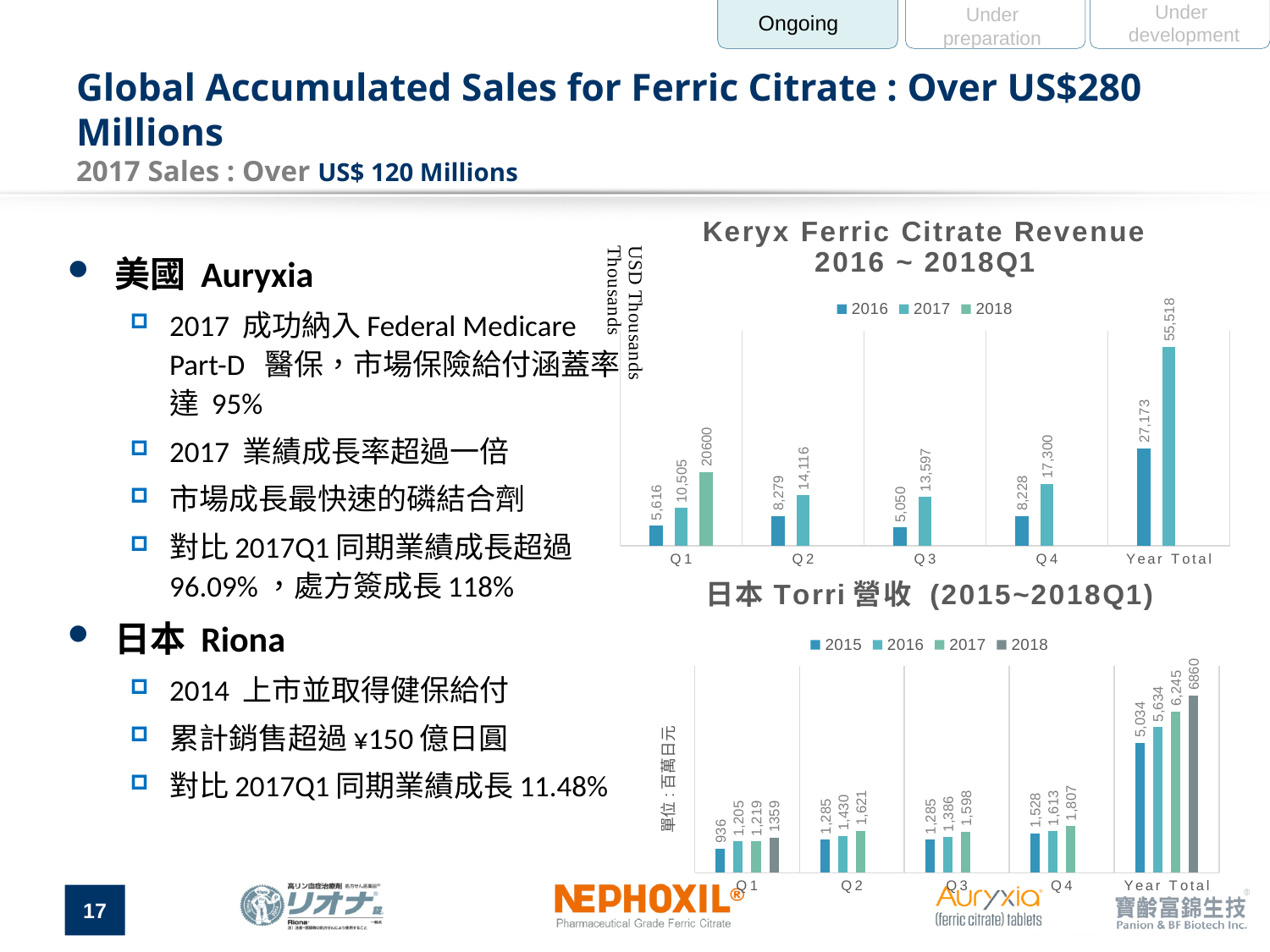
In the 日本 Torri 營收 chart, what is the 2015 value for Q1? 936 In the Keryx Ferric Citrate Revenue chart, what is the difference between the 2017 and 2016 Year Total values? 28,345 What type of chart is the Keryx Ferric Citrate Revenue chart? Bar chart In the 日本 Torri 營收 chart, what is the 2018 Year Total value? 6860 In the 日本 Torri 營收 chart, how many series does the legend list? 4 In the 日本 Torri 營收 chart, which quarter has the highest 2017 value? Q4 In the Keryx Ferric Citrate Revenue chart, what is the 2017 value for Q1? 10,505 In the Keryx Ferric Citrate Revenue chart, which quarter has the lowest 2016 value? Q3 In the Keryx Ferric Citrate Revenue chart, what is the 2017 Year Total? 55,518 In the Keryx Ferric Citrate Revenue chart, what is the 2018 value for Q1? 20600 In the 日本 Torri 營收 chart, is the 2016 value for Q2 or the 2016 value for Q3 larger? Q2 In the Keryx Ferric Citrate Revenue chart, how many series does the legend list? 3